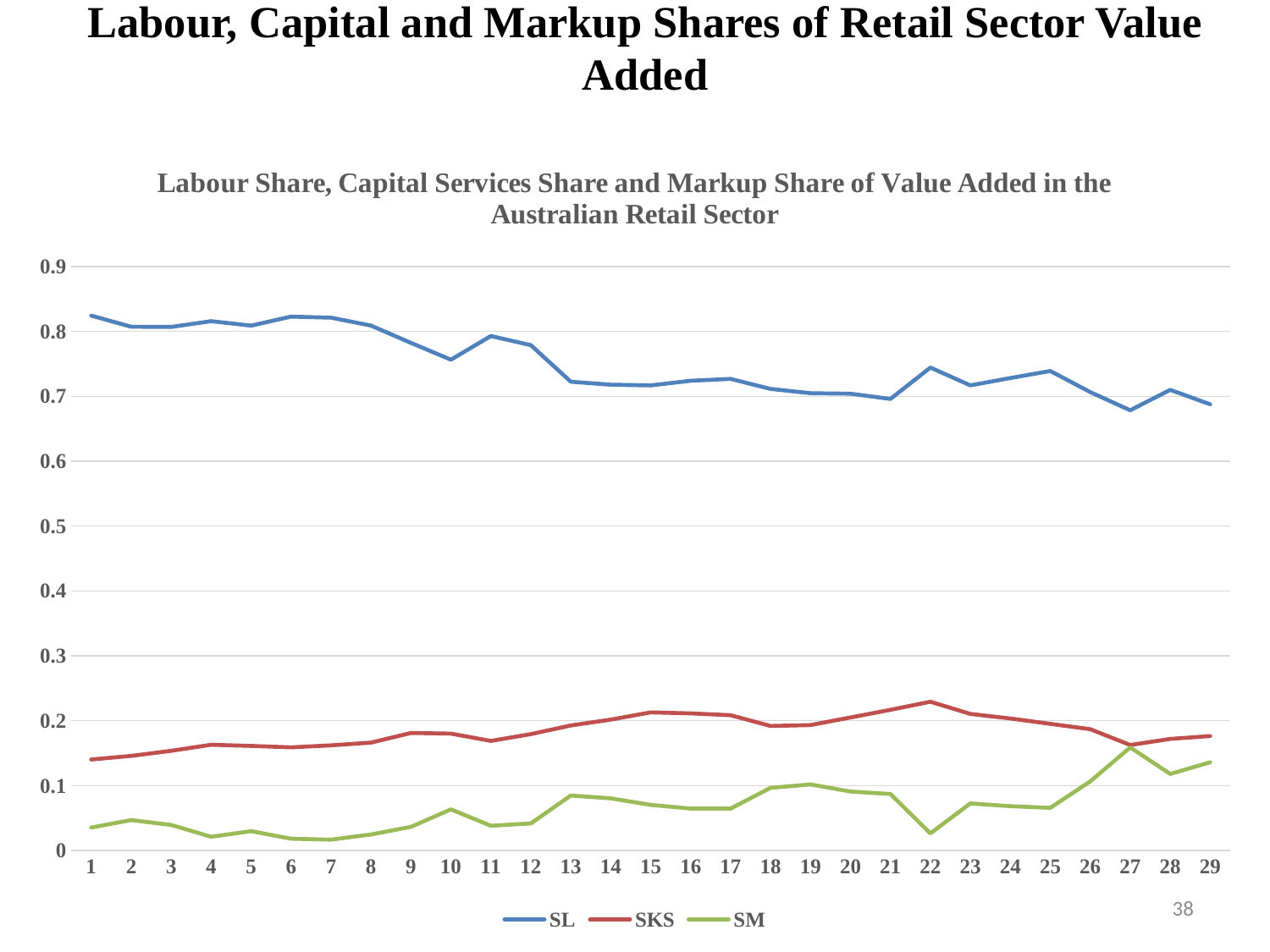
How many points are plotted along the x axis for each series? 29 At point 15, which series has the larger value, SKS or SM? SKS Is the value of SM at point 7 greater or less than 0.1? less Is the value of SL at point 27 greater or less than 0.7? less What are the three series named in the legend? SL, SKS, SM Is the value of SL at point 1 greater or less than 0.8? greater Which series has the highest values across the whole chart? SL What kind of chart is shown on the slide? line chart Does the SL series generally rise or fall from point 1 to point 29? fall What is the title printed above the chart area? Labour Share, Capital Services Share and Markup Share of Value Added in the Australian Retail Sector How many series does the legend list? 3